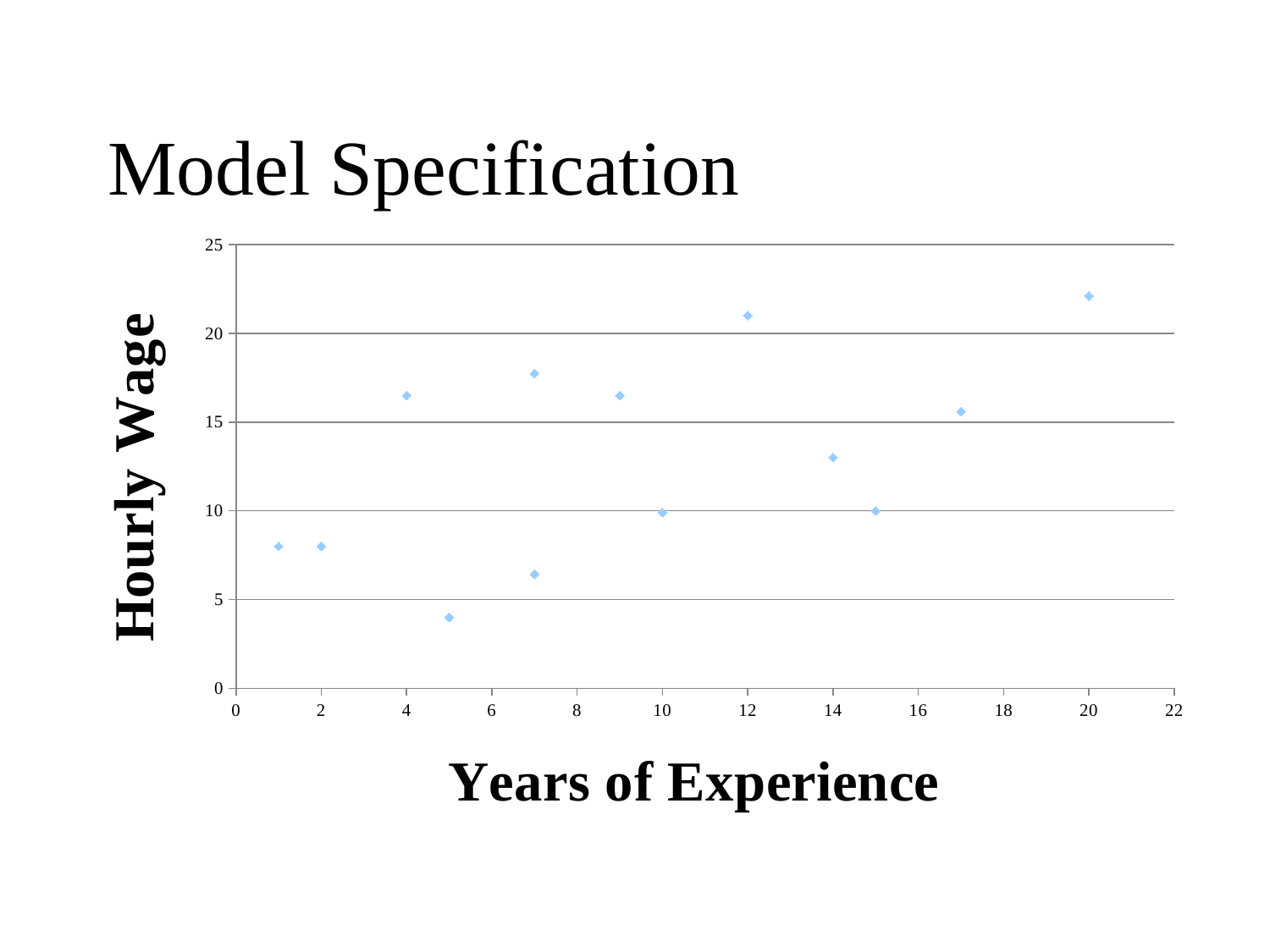
Is the Hourly Wage for 14 Years of Experience greater or less than 15? less Is the Hourly Wage for 17 Years of Experience greater or less than 15? greater What is the label of the vertical axis? Hourly Wage Is the Hourly Wage for 5 Years of Experience greater or less than 5? less How many data points are plotted on the chart? 13 Overall, does Hourly Wage tend to rise or fall as Years of Experience increases? rise At which value of Years of Experience is the lowest Hourly Wage plotted? 5 At which value of Years of Experience is the highest Hourly Wage plotted? 20 What is the title of the slide containing the chart? Model Specification What kind of chart is shown on the slide? Scatter plot